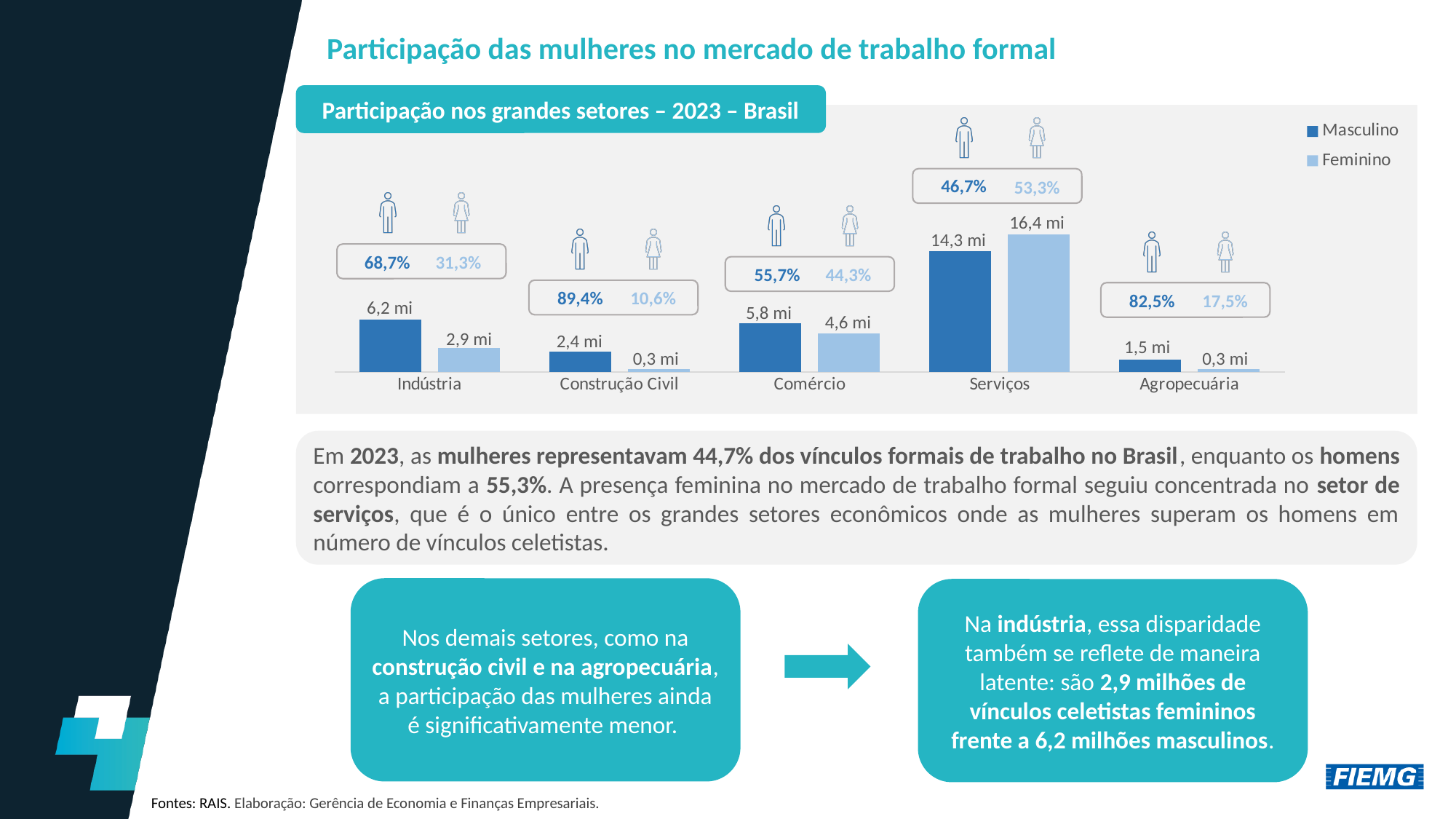
Which sector has the lowest Masculino value? Agropecuária What kind of chart is shown? Bar chart What percentage share is shown for Feminino in Agropecuária? 17,5% What is the Feminino value for Construção Civil? 0,3 mi What is the Masculino value for Indústria? 6,2 mi What is the total of the Masculino and Feminino values for Indústria? 9,1 mi What is the difference between the Masculino and Feminino values for Comércio? 1,2 mi Which sector has the highest Masculino value? Serviços How many series does the legend list? 2 How many sectors are shown on the x axis? 5 Which is larger for Serviços, the Masculino value or the Feminino value? Feminino What is the Feminino value for Serviços? 16,4 mi